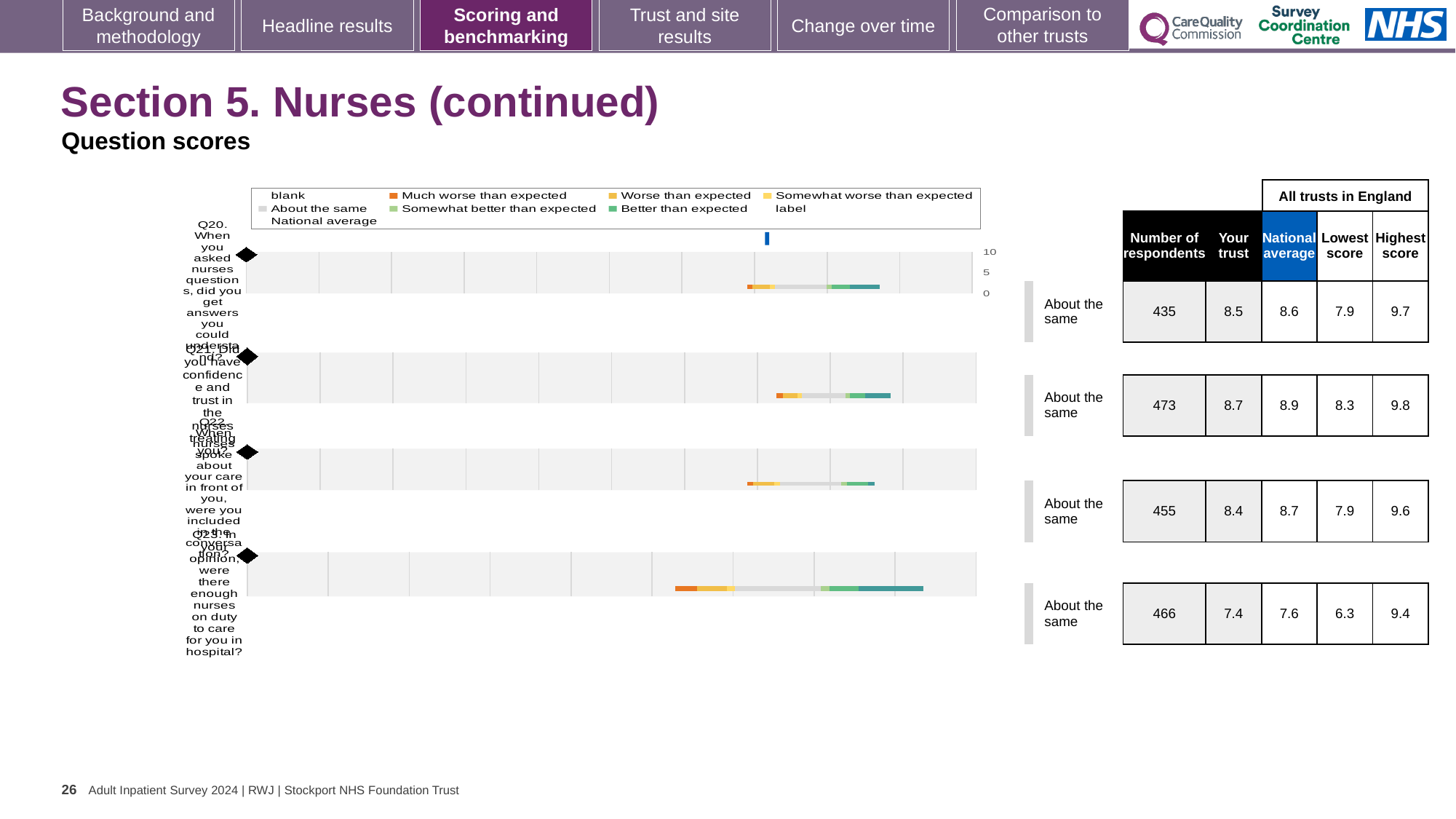
What is the highest tick value shown on the score axis of the benchmark charts? 10 How many respondents are listed for Q21 (Did you have confidence and trust in the nurses treating you)? 473 What is the difference between the national average and the 'Your trust' score for Q23? 0.2 Which question has the highest 'Your trust' score? Q21 What kind of chart is used to show the question scores for Q20 to Q23? bar chart Which question has the lowest 'Your trust' score? Q23 In the chart legend, what colour represents 'About the same'? grey What is the 'Your trust' score for Q20 (When you asked nurses questions, did you get answers you could understand)? 8.5 What is the highest score among all trusts in England for Q21? 9.8 What benchmark category is shown for all four questions on this slide? About the same For Q22, which is larger: the 'Your trust' score or the national average? National average How many questions (Q20 to Q23) have a benchmark bar chart on this slide? 4